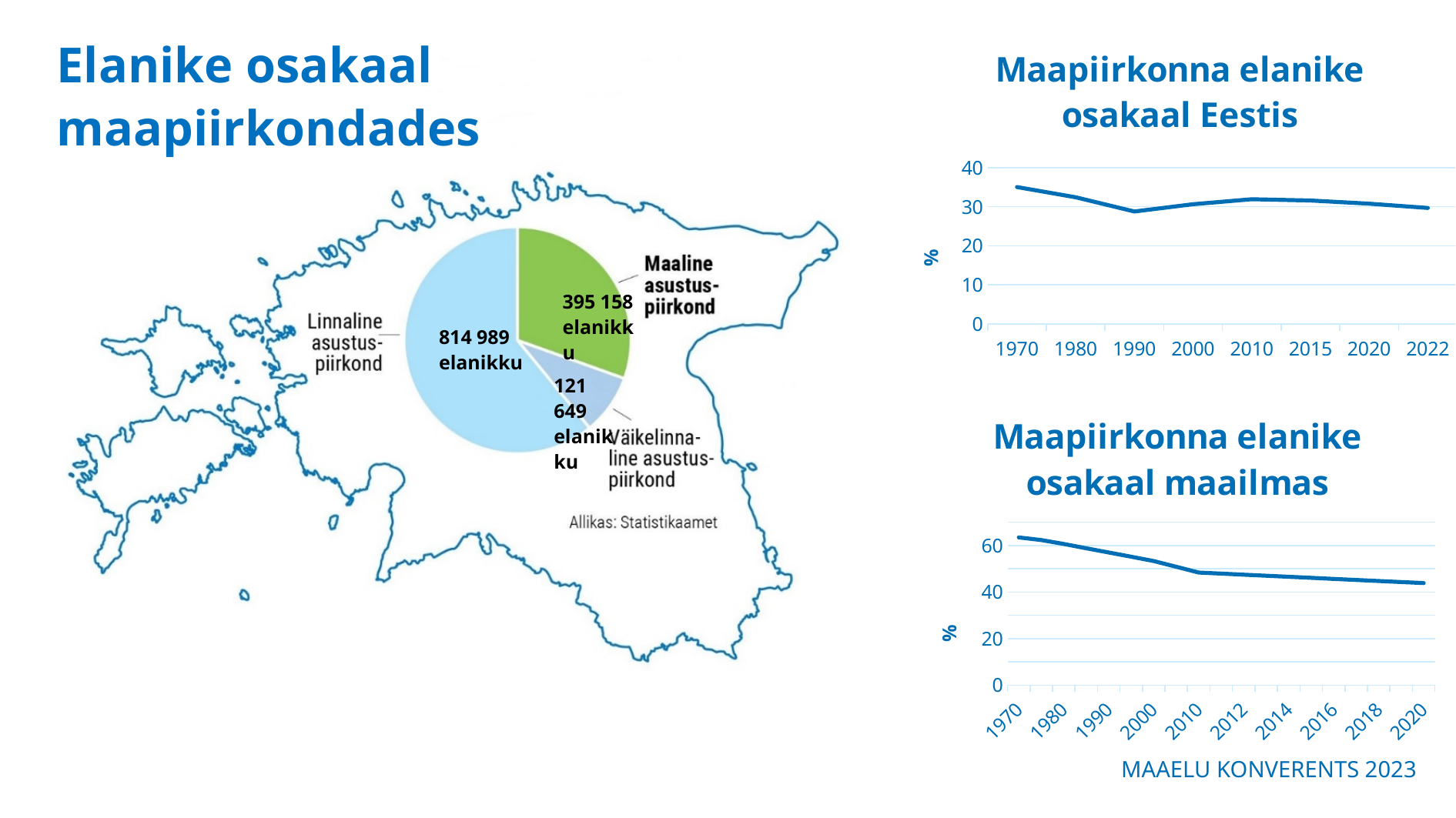
On the pie chart on the map, how many residents are in the Maaline asustuspiirkond slice? 395 158 elanikku In the chart 'Maapiirkonna elanike osakaal maailmas', do the values rise or fall from 1970 to 2020? fall On the pie chart on the map, which settlement type has the largest number of residents? Linnaline asustuspiirkond On the pie chart on the map, how many residents are in the Väikelinnaline asustuspiirkond slice? 121 649 elanikku On the pie chart on the map, what is the total number of residents across all three slices? 1 331 796 On the pie chart on the map, how many residents are in the Linnaline asustuspiirkond slice? 814 989 elanikku In the chart 'Maapiirkonna elanike osakaal Eestis', is the value for 1970 greater or less than 30? greater In the chart 'Maapiirkonna elanike osakaal maailmas', is the value for 1970 greater or less than 60? greater What kind of chart is 'Maapiirkonna elanike osakaal maailmas'? line chart On the pie chart on the map, what is the difference between the Linnaline and Maaline resident counts? 419 831 On the pie chart on the map, which settlement type has the smallest number of residents? Väikelinnaline asustuspiirkond In the chart 'Maapiirkonna elanike osakaal Eestis', how many years are marked on the x axis? 8